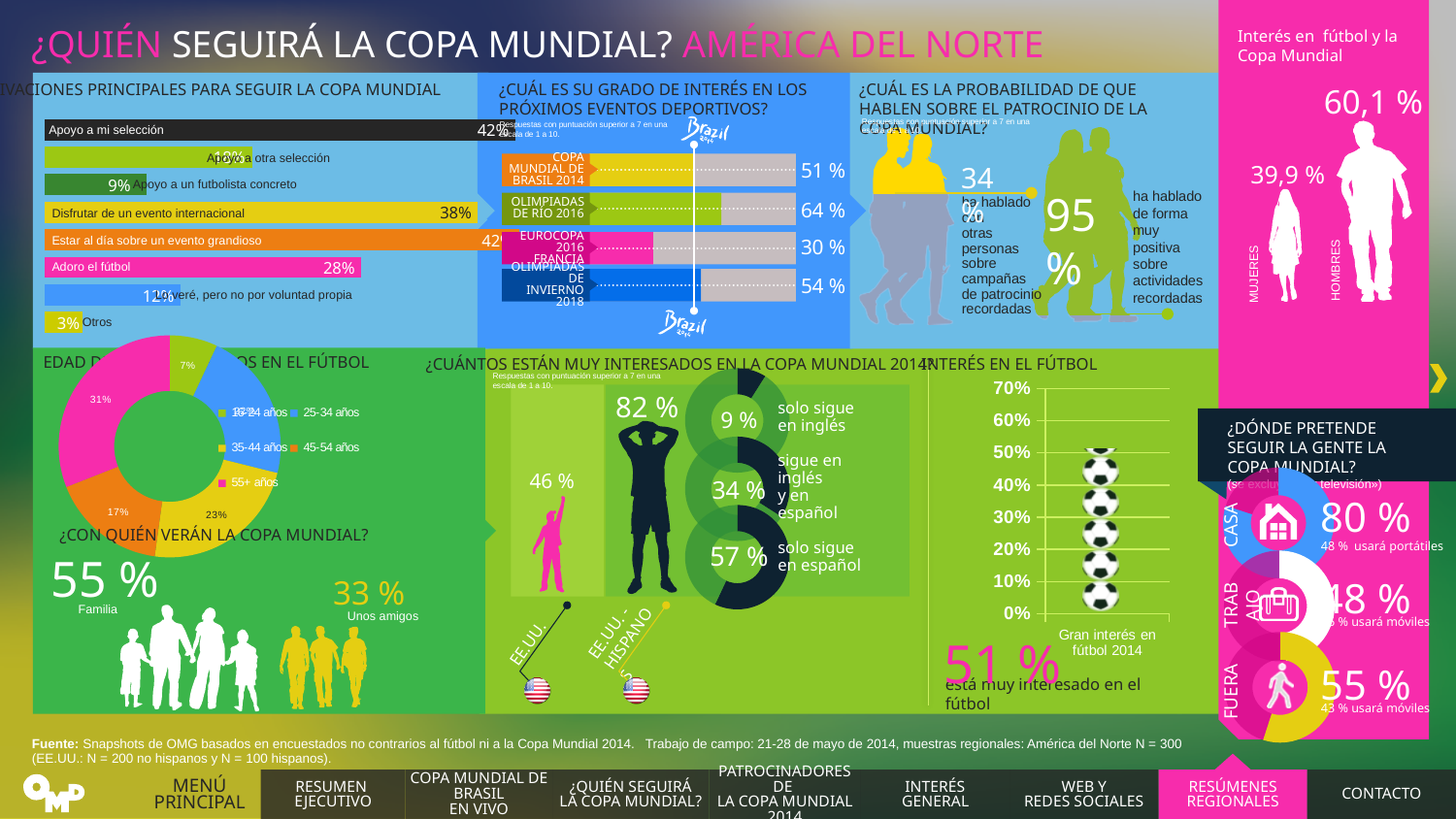
How many age groups does the legend of the 'Edad de los interesados en el fútbol' donut chart list? 5 In the 'Motivaciones principales para seguir la Copa Mundial' chart, which is larger: 'Adoro el fútbol' or 'Apoyo a un futbolista concreto'? Adoro el fútbol In the chart '¿Cuál es su grado de interés en los próximos eventos deportivos?', how many events are listed? 4 In the 'Interés en fútbol y la Copa Mundial' chart, what is the value for Hombres? 60,1 % In the chart '¿Cuál es su grado de interés en los próximos eventos deportivos?', what is the difference between Olimpiadas de Río 2016 and Copa Mundial de Brasil 2014? 13 % In the '¿Con quién verán la Copa Mundial?' chart, what is the value for Familia? 55 % In the chart '¿Cuál es su grado de interés en los próximos eventos deportivos?', which event has the lowest value? Eurocopa 2016 Francia In the 'Motivaciones principales para seguir la Copa Mundial' chart, what is the value for 'Disfrutar de un evento internacional'? 38% In the 'Interés en fútbol y la Copa Mundial' chart, what is the difference between Hombres and Mujeres? 20,2 % In the chart '¿Cuál es su grado de interés en los próximos eventos deportivos?', what is the value for Olimpiadas de Río 2016? 64 % In the 'Motivaciones principales para seguir la Copa Mundial' chart, what is the value for 'Otros'? 3% In the '¿Dónde pretende seguir la gente la Copa Mundial?' chart, what is the value for Casa? 80 %